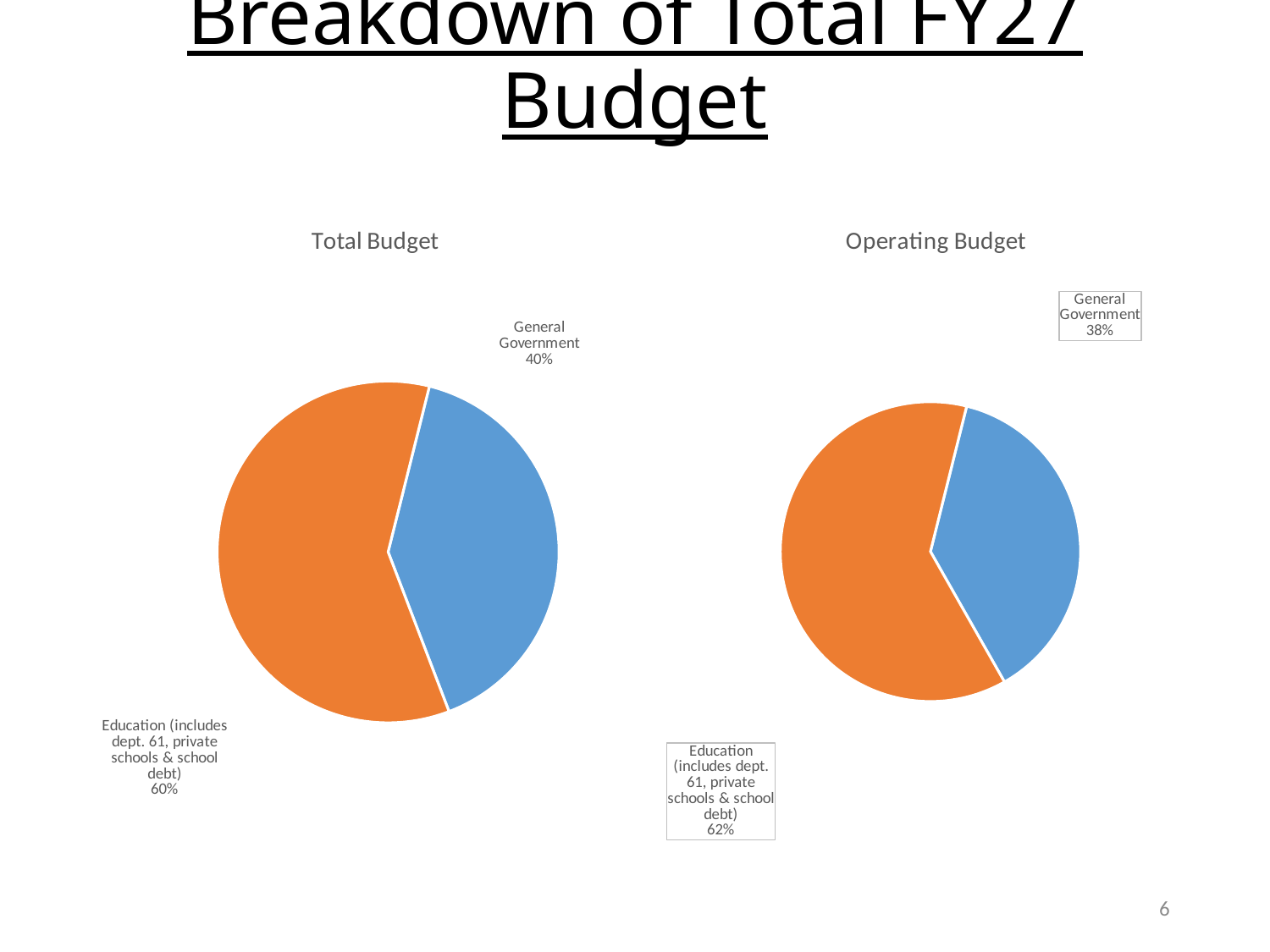
Is the General Government share larger in the Total Budget chart or the Operating Budget chart? Total Budget In the Total Budget chart, what share of the pie is General Government? 40% What kind of chart is the Total Budget chart? Pie chart What colour is the General Government slice in the Total Budget chart? Blue In the Operating Budget chart, which slice is the smallest? General Government In the Total Budget chart, what is the difference in percentage points between the Education slice and the General Government slice? 20 percentage points In the Operating Budget chart, what is the difference in percentage points between the Education slice and the General Government slice? 24 percentage points In the Operating Budget chart, what share of the pie is General Government? 38% In the Operating Budget chart, what share of the pie is Education (includes dept. 61, private schools & school debt)? 62% How many slices does the Operating Budget chart have? 2 In the Total Budget chart, which slice is the largest? Education (includes dept. 61, private schools & school debt)